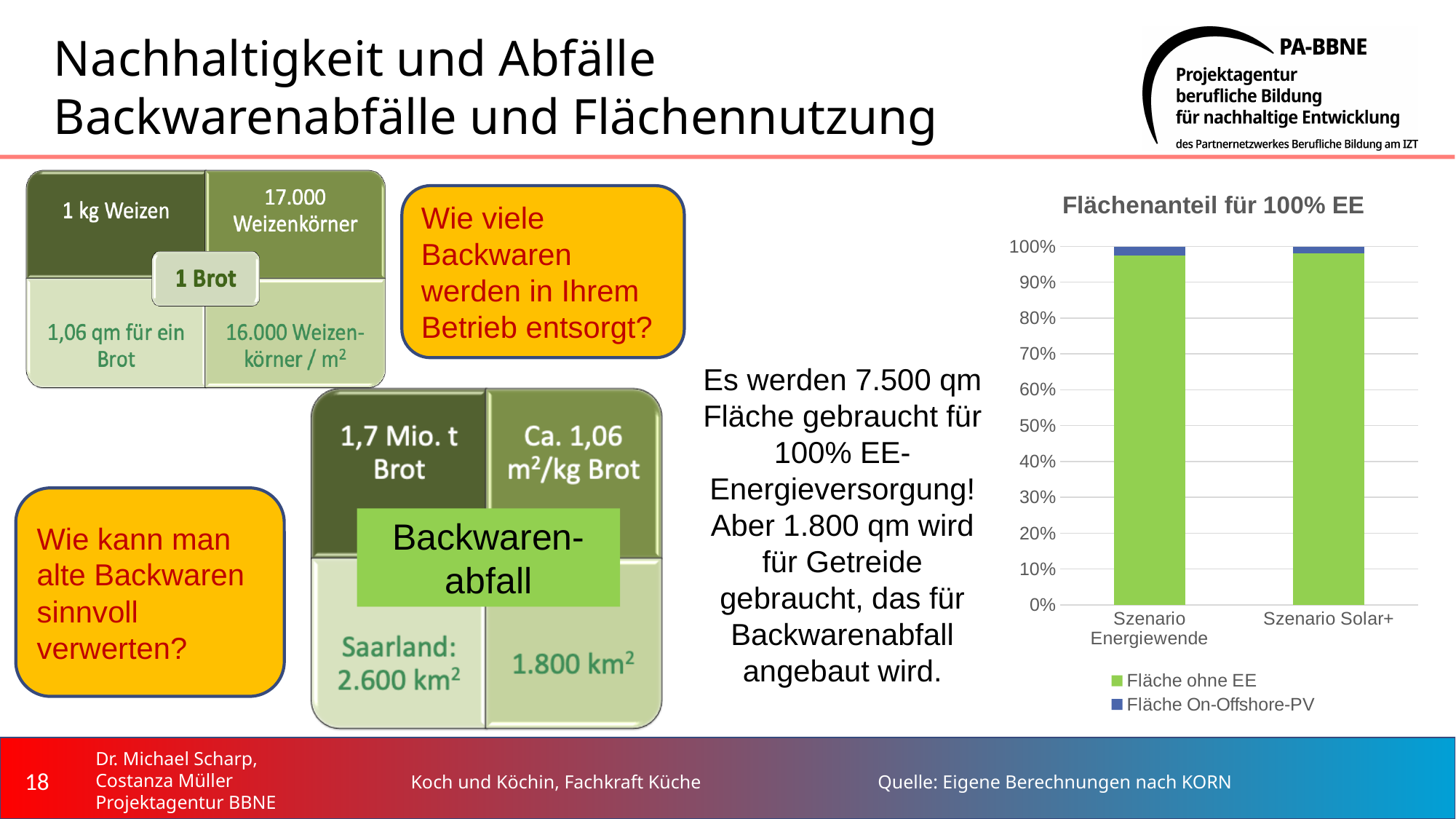
What kind of chart is shown under the title "Flächenanteil für 100% EE"? stacked bar chart Is the value of "Fläche ohne EE" for Szenario Solar+ greater or less than 50%? greater How many scenarios (categories) are shown on the x axis of the chart? 2 Is the value of "Fläche ohne EE" for Szenario Energiewende greater or less than 90%? greater What are the two category labels on the x axis of the chart? Szenario Energiewende, Szenario Solar+ What is the total height of the stacked bar for Szenario Energiewende? 100% Which series is shown in green in the chart? Fläche ohne EE In the Szenario Energiewende bar, which series takes the larger share: Fläche ohne EE or Fläche On-Offshore-PV? Fläche ohne EE Is the value of "Fläche On-Offshore-PV" for Szenario Solar+ greater or less than 10%? less What is the title of the chart on the slide? Flächenanteil für 100% EE In the Szenario Solar+ bar, which series takes the smaller share: Fläche ohne EE or Fläche On-Offshore-PV? Fläche On-Offshore-PV How many series does the chart legend list? 2